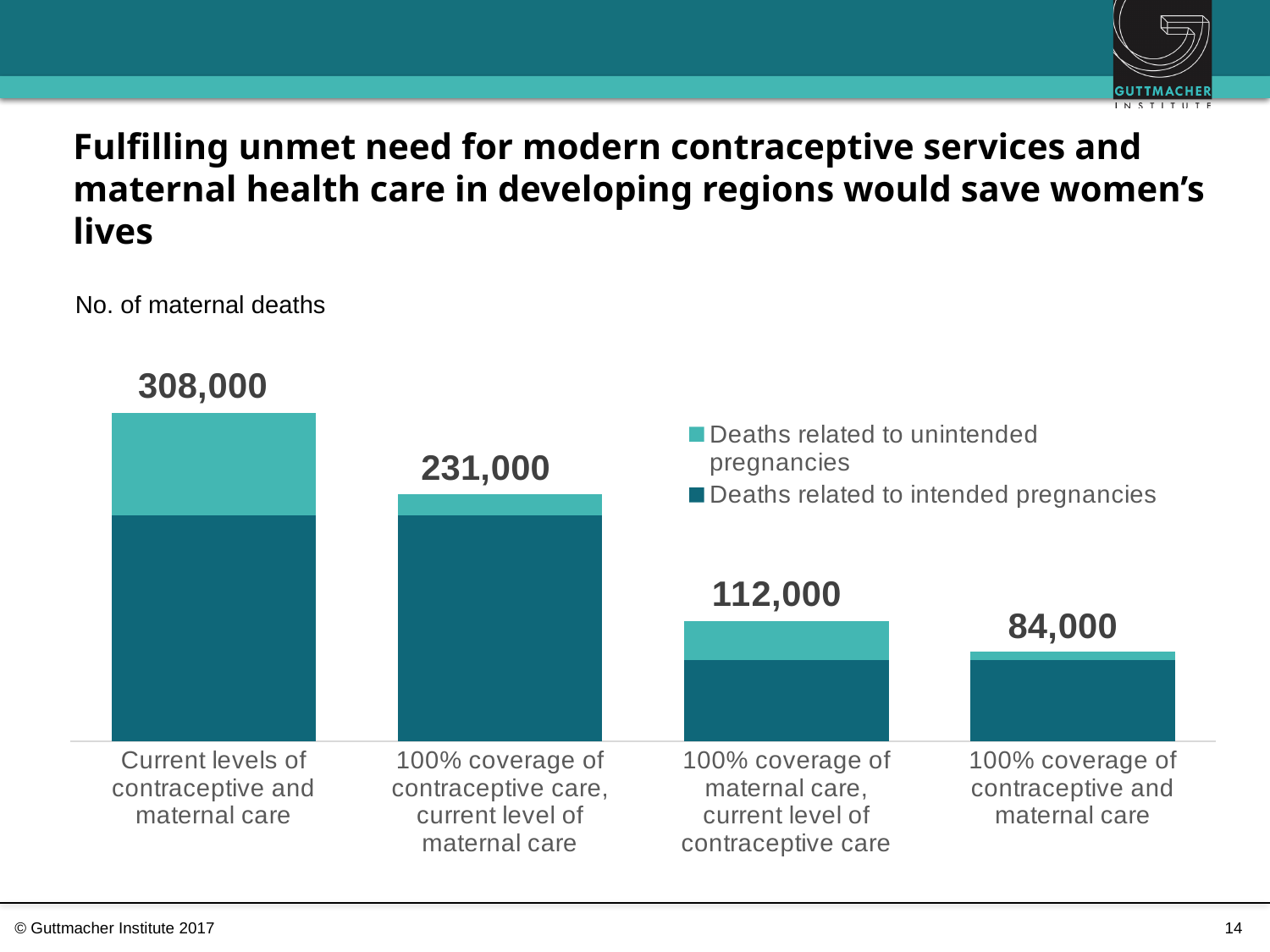
Which scenario has the highest total number of maternal deaths? Current levels of contraceptive and maternal care What is the total number of maternal deaths shown for '100% coverage of maternal care, current level of contraceptive care'? 112,000 What is the difference in total maternal deaths between 'Current levels of contraceptive and maternal care' and '100% coverage of contraceptive and maternal care'? 224,000 How many series does the legend list? 2 Do the total maternal deaths rise or fall moving from left to right across the bars? Fall Which scenario has the lowest total number of maternal deaths? 100% coverage of contraceptive and maternal care What is the total number of maternal deaths shown for '100% coverage of contraceptive and maternal care'? 84,000 Which has more total maternal deaths: '100% coverage of contraceptive care, current level of maternal care' or '100% coverage of maternal care, current level of contraceptive care'? 100% coverage of contraceptive care, current level of maternal care What kind of chart is shown on the slide? Stacked bar chart How many scenarios (bars) are shown in the chart? 4 What is the total number of maternal deaths shown for '100% coverage of contraceptive care, current level of maternal care'? 231,000 What is the total number of maternal deaths shown for 'Current levels of contraceptive and maternal care'? 308,000